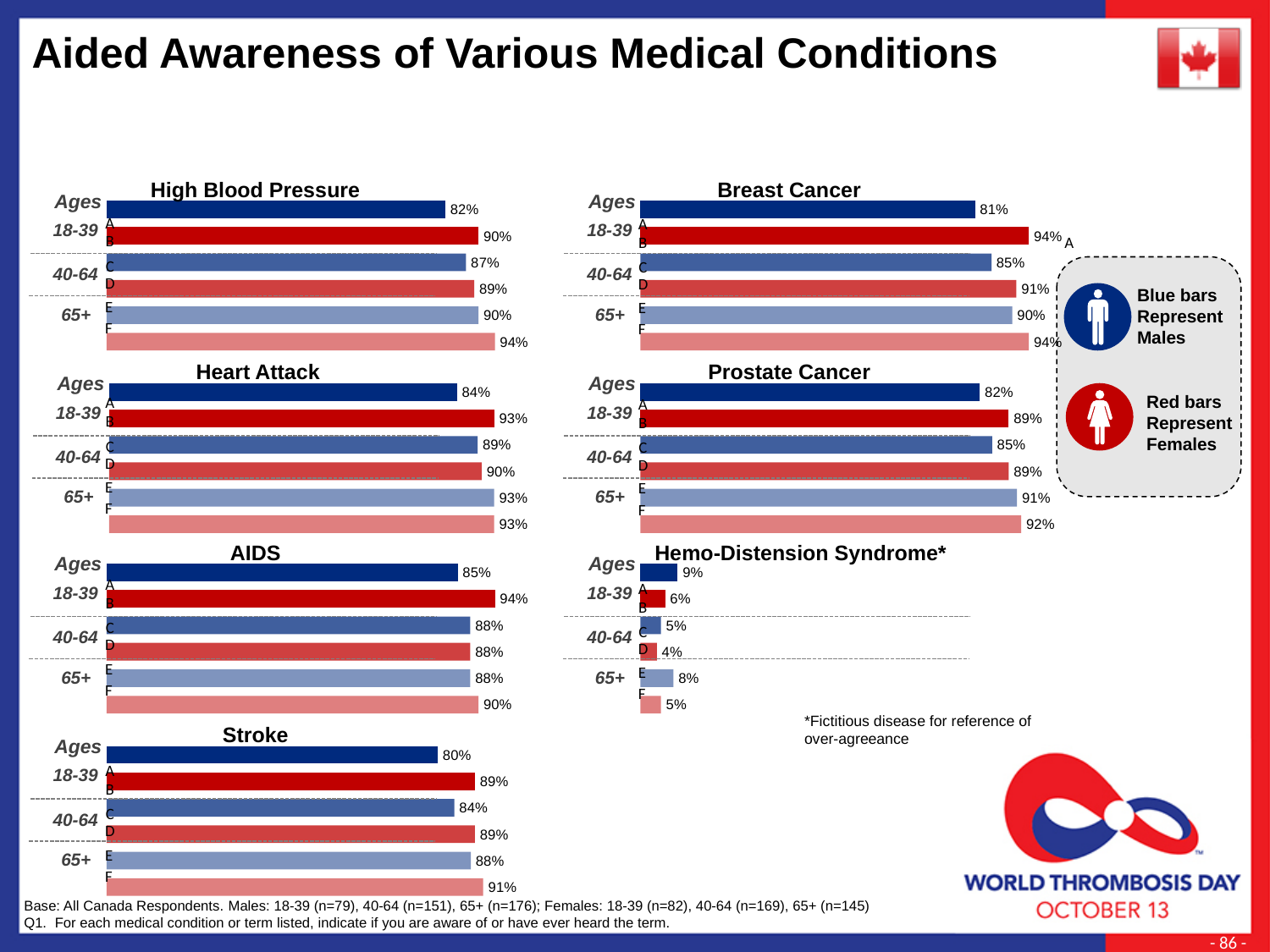
In the Hemo-Distension Syndrome chart, which bar has the highest value? Males 18-39 In the Stroke chart, which is larger: males aged 18-39 or females aged 18-39? Females 18-39 In the Prostate Cancer chart, what is the difference between females aged 65+ and males aged 18-39? 10 percentage points In the Stroke chart, what is the value for females aged 65+? 91% In the AIDS chart, which bar has the lowest value? Males 18-39 How many bars are shown in the Hemo-Distension Syndrome chart? 6 In the High Blood Pressure chart, which bar has the highest value? Females 65+ In the High Blood Pressure chart, what is the value for males aged 18-39? 82% In the Breast Cancer chart, what is the value for females aged 40-64? 91% What type of chart is used for the Stroke data? Bar chart In the Heart Attack chart, what is the difference between females aged 18-39 and males aged 18-39? 9 percentage points In the Heart Attack chart, what is the value for females aged 18-39? 93%